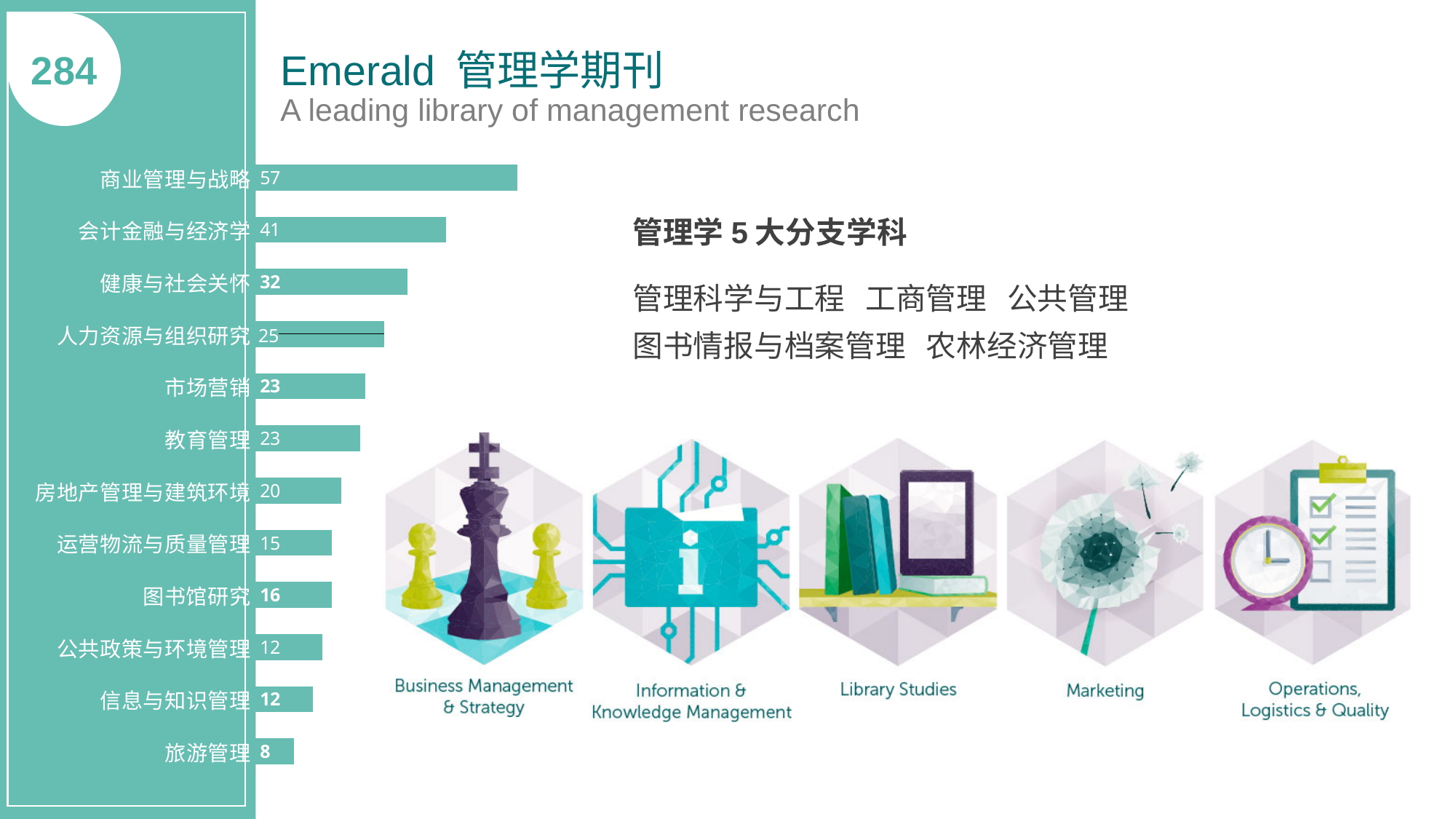
Which has a larger value, 健康与社会关怀 or 人力资源与组织研究? 健康与社会关怀 Which category has the lowest value in the bar chart? 旅游管理 What is the difference between the values for 商业管理与战略 and 会计金融与经济学? 16 What value is shown for 会计金融与经济学? 41 What value is shown for 旅游管理? 8 Which category has the highest value in the bar chart? 商业管理与战略 What value is shown for 房地产管理与建筑环境? 20 What kind of chart is shown on the slide? Bar chart What value is shown for 商业管理与战略? 57 What number is shown in the circle at the top left of the slide? 284 How many categories are shown in the bar chart? 12 What is the difference between the values for 市场营销 and 旅游管理? 15